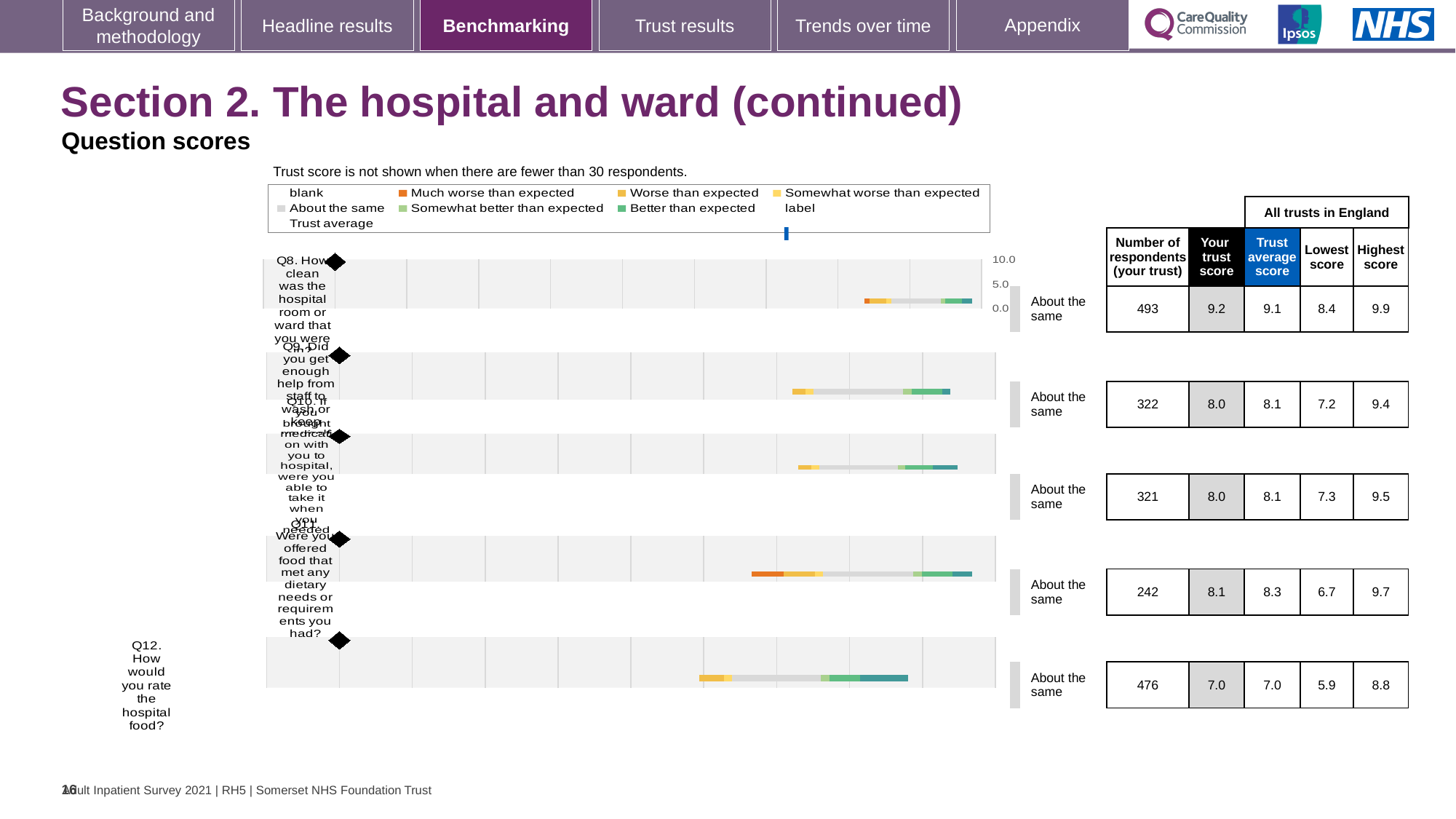
What kind of chart is used to show the question scores on this slide? bar chart What is the lowest score across all trusts in England for Q12? 5.9 What benchmark category is shown for all five questions on this slide? About the same Which question has the highest 'Your trust score'? Q8 What is the 'Trust average score' for Q11 (offered food that met dietary needs)? 8.3 What is the number of respondents for Q12 (how would you rate the hospital food)? 476 What is the highest score across all trusts in England for Q10? 9.5 Which question has the lowest 'Your trust score'? Q12 What is the difference between the 'Your trust score' for Q8 and for Q12? 2.2 Which question has more respondents, Q9 or Q11? Q9 What is the 'Your trust score' for Q8 (how clean was the hospital room or ward)? 9.2 How many questions (Q8 to Q12) are plotted in the question scores chart? 5